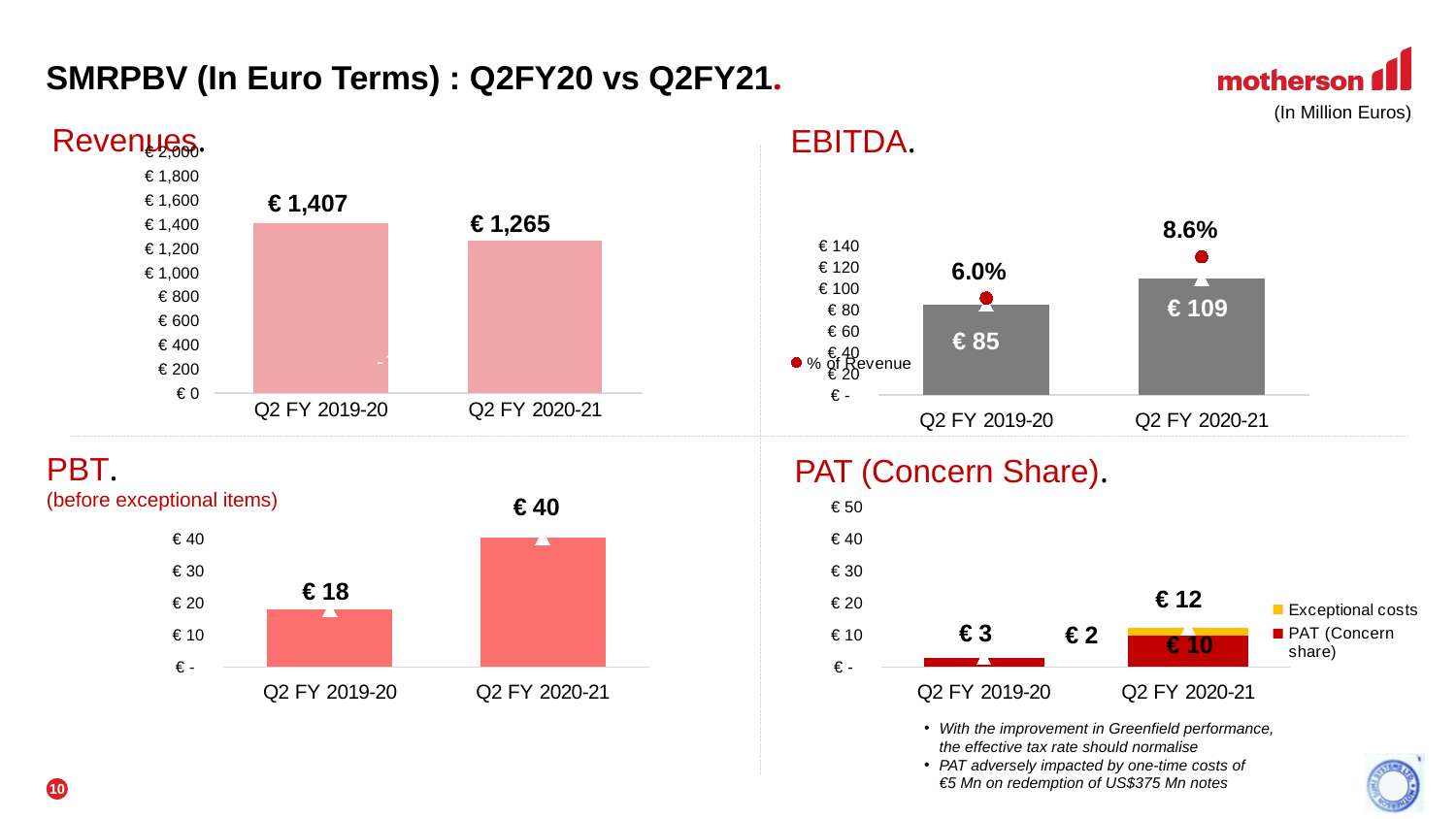
In the EBITDA chart, what is the % of Revenue for Q2 FY 2019-20? 6.0% In the Revenues chart, do values rise or fall from Q2 FY 2019-20 to Q2 FY 2020-21? fall In the PAT (Concern Share) chart, how many series does the legend list? 2 In the Revenues chart, what is the difference between Q2 FY 2019-20 and Q2 FY 2020-21? € 142 In the EBITDA chart, which quarter has the higher EBITDA? Q2 FY 2020-21 In the Revenues chart, what is the value for Q2 FY 2020-21? € 1,265 In the PBT chart, what is the value for Q2 FY 2019-20? € 18 In the EBITDA chart, what is the value for Q2 FY 2020-21? € 109 In the Revenues chart, what is the value for Q2 FY 2019-20? € 1,407 What kind of chart is the PBT chart? bar chart In the PBT chart, what is the difference between Q2 FY 2020-21 and Q2 FY 2019-20? € 22 In the EBITDA chart, what is the difference between Q2 FY 2020-21 and Q2 FY 2019-20? € 24